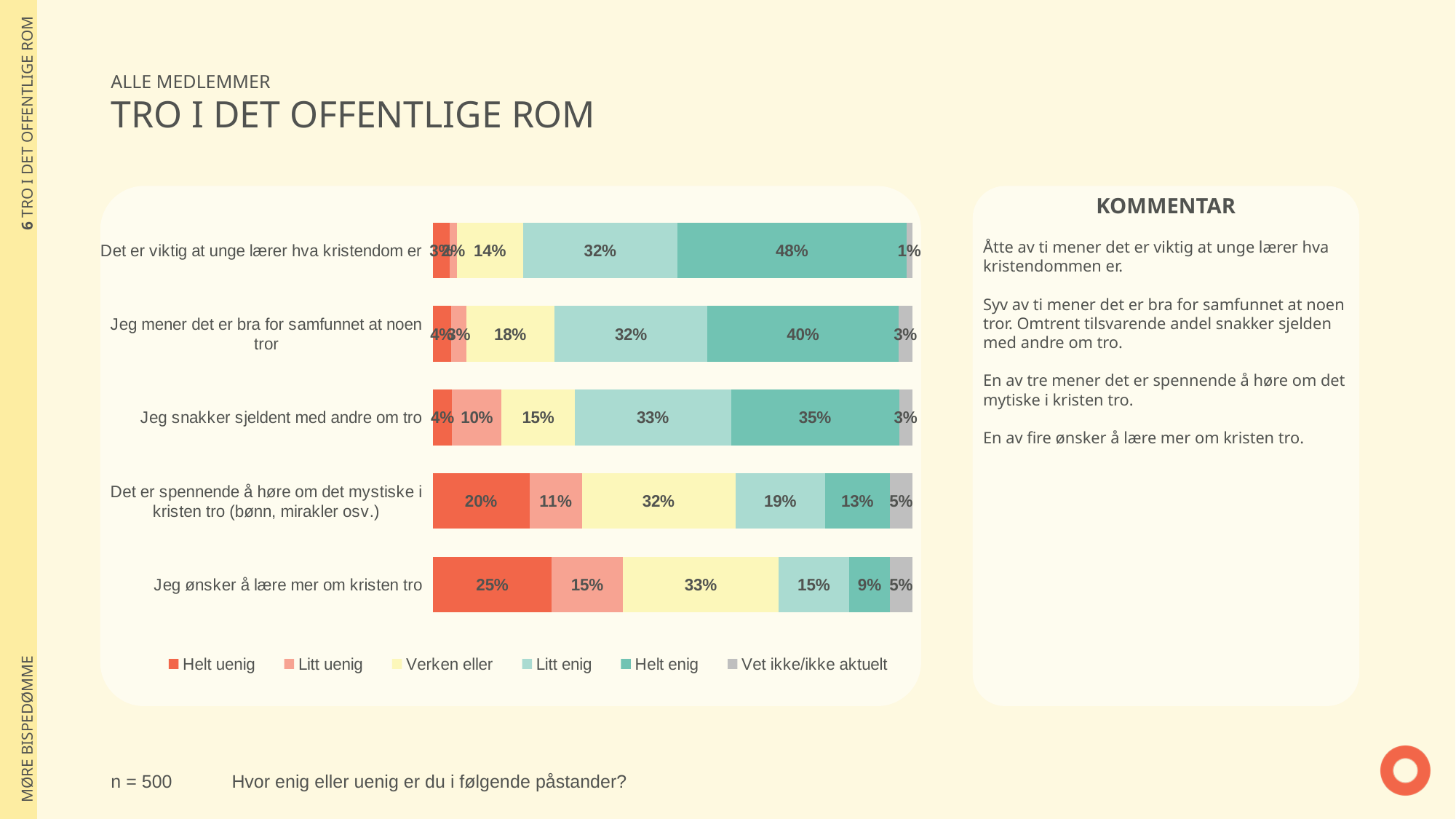
What is the "Vet ikke/ikke aktuelt" share for "Jeg mener det er bra for samfunnet at noen tror"? 3% What kind of chart is shown on the slide? Stacked bar chart How many response categories does the legend list? 6 Which statement has the highest "Helt enig" share? Det er viktig at unge lærer hva kristendom er What is the "Litt enig" share for "Jeg snakker sjeldent med andre om tro"? 33% What percentage answered "Helt uenig" to "Jeg ønsker å lære mer om kristen tro"? 25% Which has the larger "Helt uenig" share: "Det er spennende å høre om det mystiske i kristen tro (bønn, mirakler osv.)" or "Jeg ønsker å lære mer om kristen tro"? Jeg ønsker å lære mer om kristen tro What is the difference in "Helt enig" share between "Det er viktig at unge lærer hva kristendom er" and "Jeg ønsker å lære mer om kristen tro"? 39 percentage points What is the "Verken eller" share for "Det er spennende å høre om det mystiske i kristen tro (bønn, mirakler osv.)"? 32% How many statements are shown in the chart? 5 What percentage of respondents answered "Helt enig" to "Det er viktig at unge lærer hva kristendom er"? 48% Which statement has the highest "Helt uenig" share? Jeg ønsker å lære mer om kristen tro